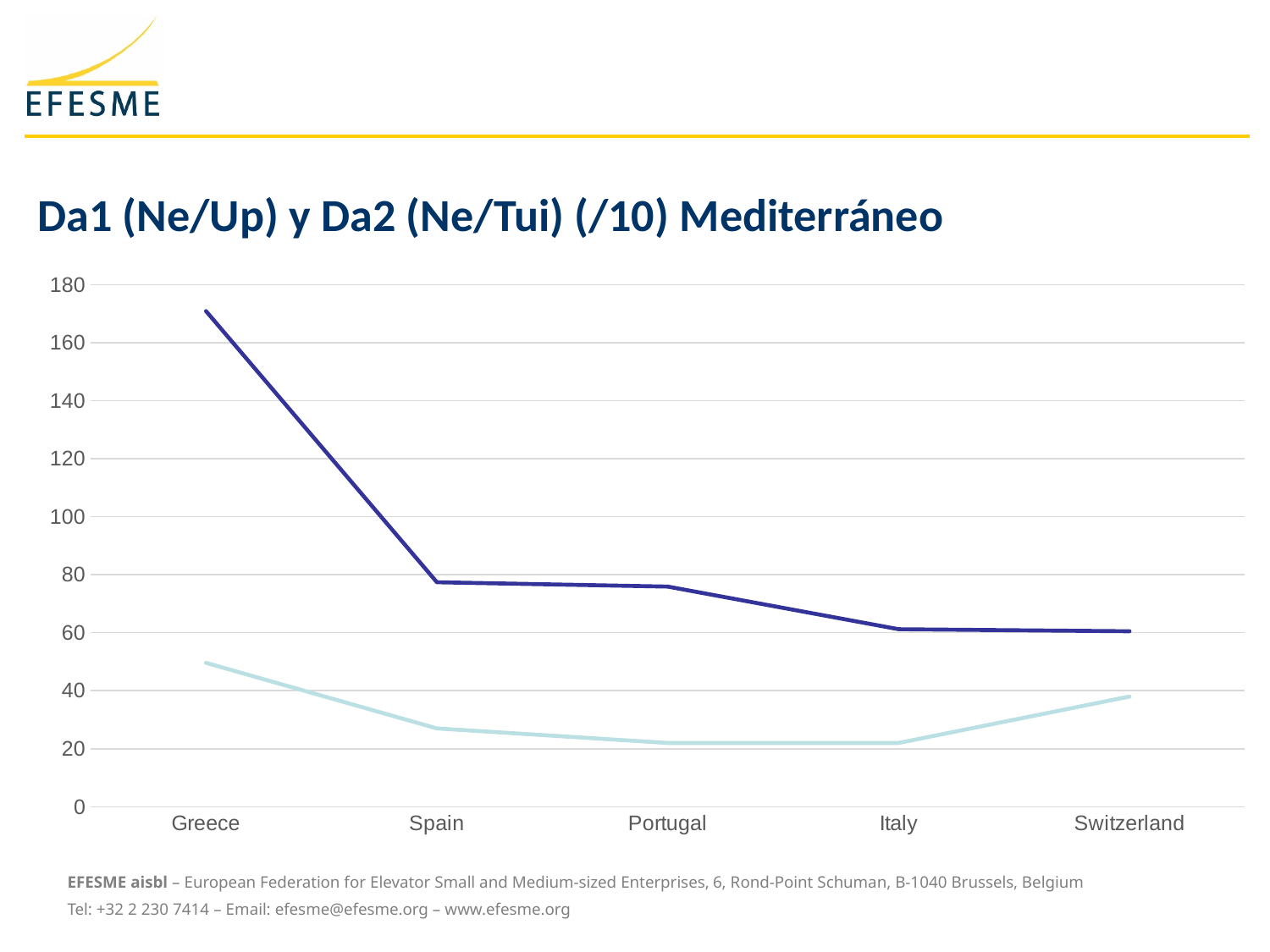
What kind of chart is shown on the slide? line chart For which country is the light blue line highest? Greece What is the title of the chart? Da1 (Ne/Up) y Da2 (Ne/Tui) (/10) Mediterráneo Is the value of the dark blue line for Spain greater or less than 100? less For which country is the dark blue line highest? Greece Does the dark blue line rise or fall from Greece to Switzerland? fall How many countries are shown on the x axis of the chart? 5 Is the value of the light blue line for Greece greater or less than 60? less How many lines are plotted on the chart? 2 Is the value of the light blue line for Switzerland greater or less than 20? greater For Greece, which line has the larger value, the dark blue line or the light blue line? the dark blue line